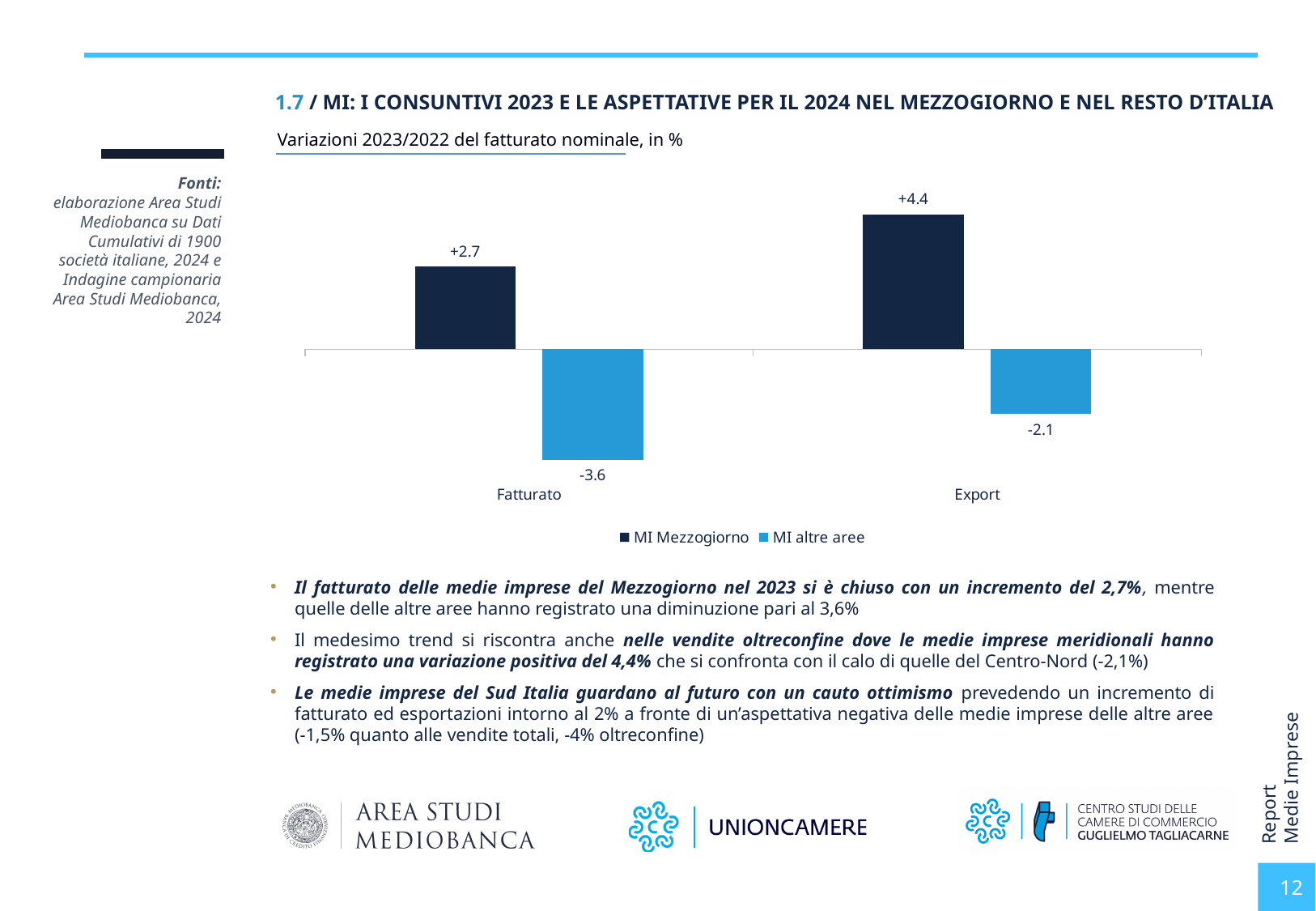
Which bar has the lowest value in the chart? MI altre aree, Fatturato (-3.6) What is the value for MI altre aree in the Export category? -2.1 What is the value for MI altre aree in the Fatturato category? -3.6 What kind of chart is shown on the slide? Bar chart How many series does the legend list? 2 What is the difference between the MI Mezzogiorno values for Export and Fatturato? 1.7 What is the value for MI Mezzogiorno in the Fatturato category? +2.7 Which bar has the highest value in the chart? MI Mezzogiorno, Export (+4.4) Is the MI Mezzogiorno value larger for Fatturato or for Export? Export What is the subtitle of the chart? Variazioni 2023/2022 del fatturato nominale, in % How many categories are shown on the x axis of the chart? 2 What is the value for MI Mezzogiorno in the Export category? +4.4